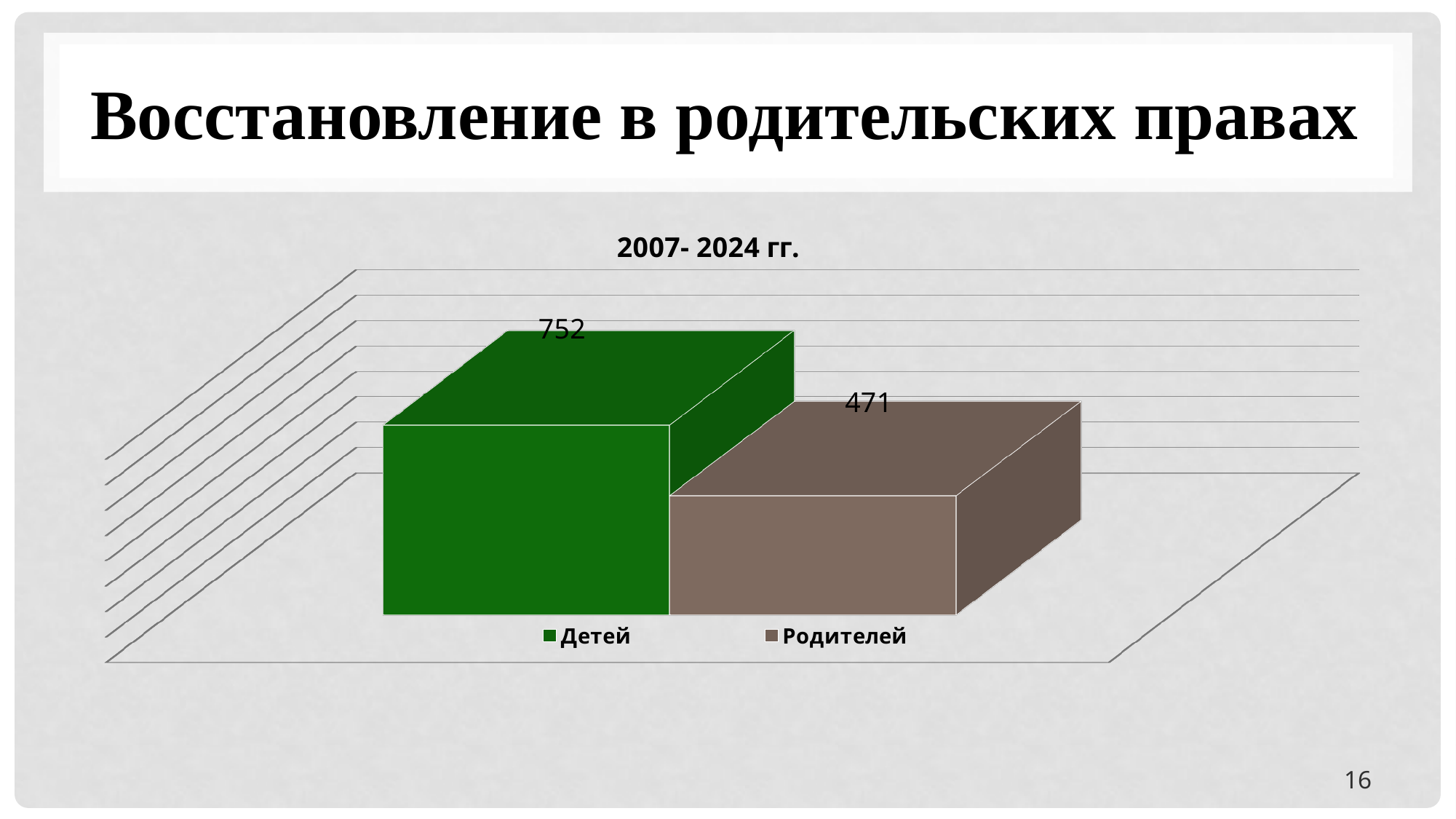
What is the value for Детей? 752 How many bars are plotted on the chart? 2 What is the value for Родителей? 471 Which series has the lowest value? Родителей Which series has the highest value? Детей What is the difference between the values for Детей and Родителей? 281 How many series does the legend list? 2 What colour is the bar for Детей? green What kind of chart is shown on the slide? bar chart What is the title of the chart? 2007- 2024 гг. Which is larger, the value for Детей or the value for Родителей? Детей